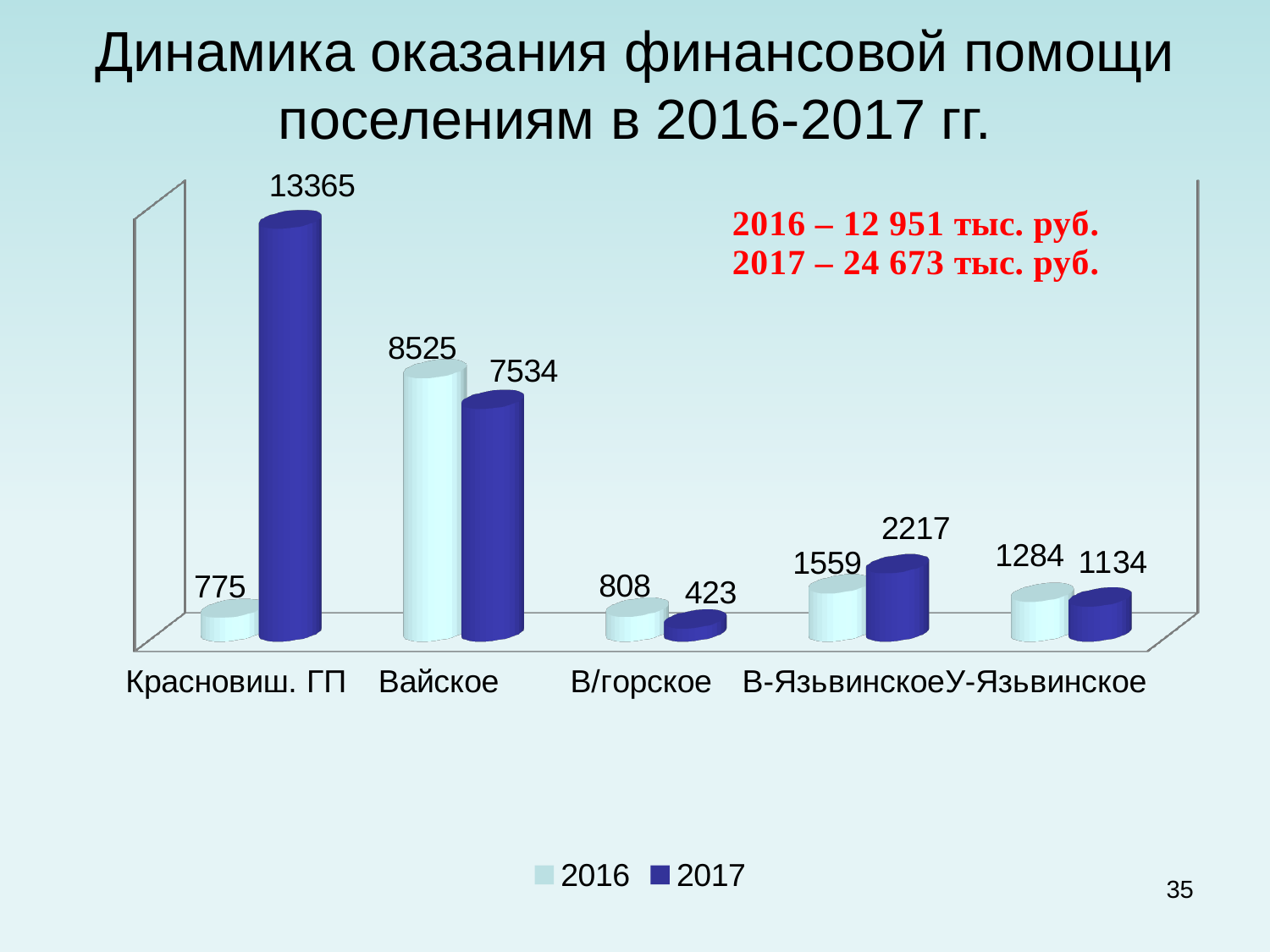
What kind of chart is shown on the slide? bar chart Which category has the highest 2017 value? Красновиш. ГП What is the 2017 value for Красновиш. ГП? 13365 What is the difference between the 2017 and 2016 values for Красновиш. ГП? 12590 What is the 2017 value for В/горское? 423 Which category has the lowest 2016 value? Красновиш. ГП What is the difference between the 2016 and 2017 values for Вайское? 991 What is the 2016 value for У-Язьвинское? 1284 Which is larger for В-Язьвинское, the 2016 value or the 2017 value? 2017 How many categories are shown on the x axis? 5 What is the 2016 value for Вайское? 8525 How many series does the legend list? 2